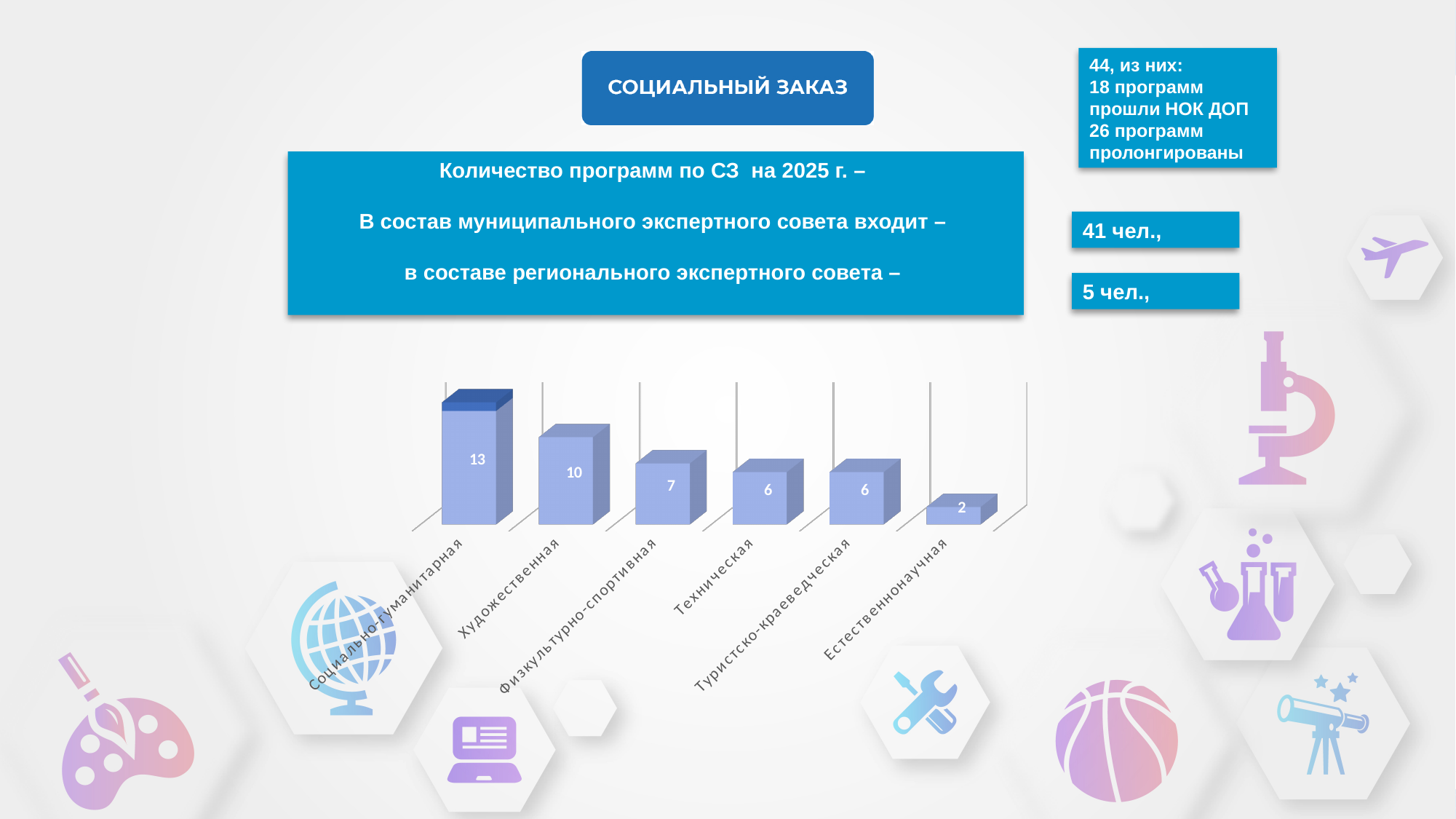
What is the value for Художественная? 10 What is the value for Естественнонаучная? 2 Do the values rise or fall from left to right across the categories? fall What is the difference between the values for Социально-гуманитарная and Художественная? 3 What is the difference between the values for Физкультурно-спортивная and Естественнонаучная? 5 Which category has the lowest value? Естественнонаучная What is the value for Социально-гуманитарная? 13 Which category has the highest value? Социально-гуманитарная What is the value for Физкультурно-спортивная? 7 How many categories are shown in the chart? 6 What kind of chart is shown on the slide? bar chart Which is larger, the value for Художественная or the value for Техническая? Художественная